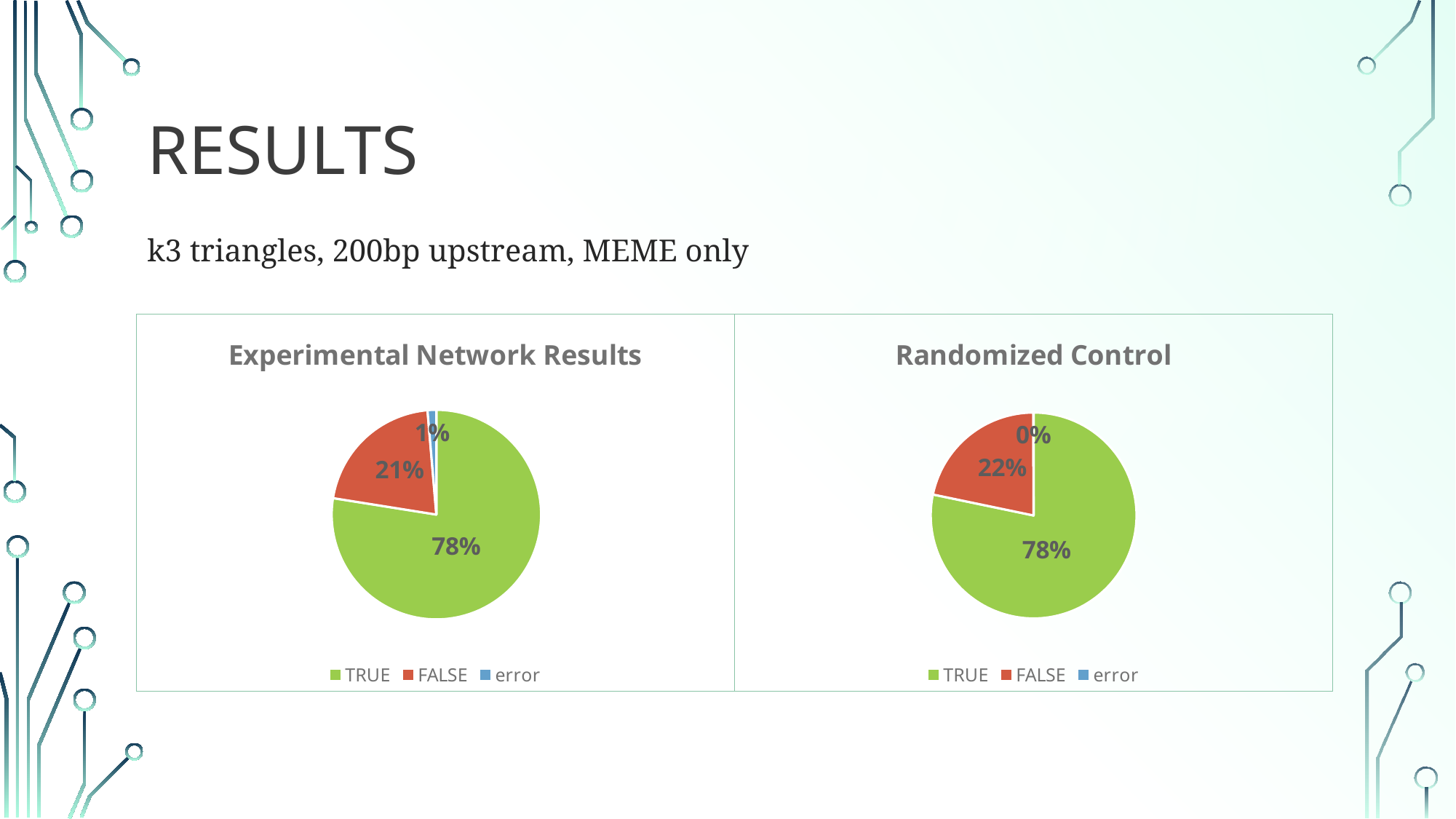
In the Experimental Network Results chart, what share of the pie is TRUE? 78% In the Experimental Network Results chart, what share of the pie is error? 1% How many categories does the legend of the Randomized Control chart list? 3 In the Experimental Network Results chart, what share of the pie is FALSE? 21% What kind of chart is the Experimental Network Results chart? Pie chart In the Randomized Control chart, which category has the largest slice? TRUE In the Experimental Network Results chart, which category has the smallest slice? error What is the difference between the FALSE share in the Randomized Control chart and the FALSE share in the Experimental Network Results chart? 1% In the Experimental Network Results chart, which is larger, the TRUE slice or the FALSE slice? TRUE In the Randomized Control chart, what share of the pie is error? 0% In the Randomized Control chart, what share of the pie is FALSE? 22% In the Experimental Network Results chart, what colour is the FALSE slice? Red